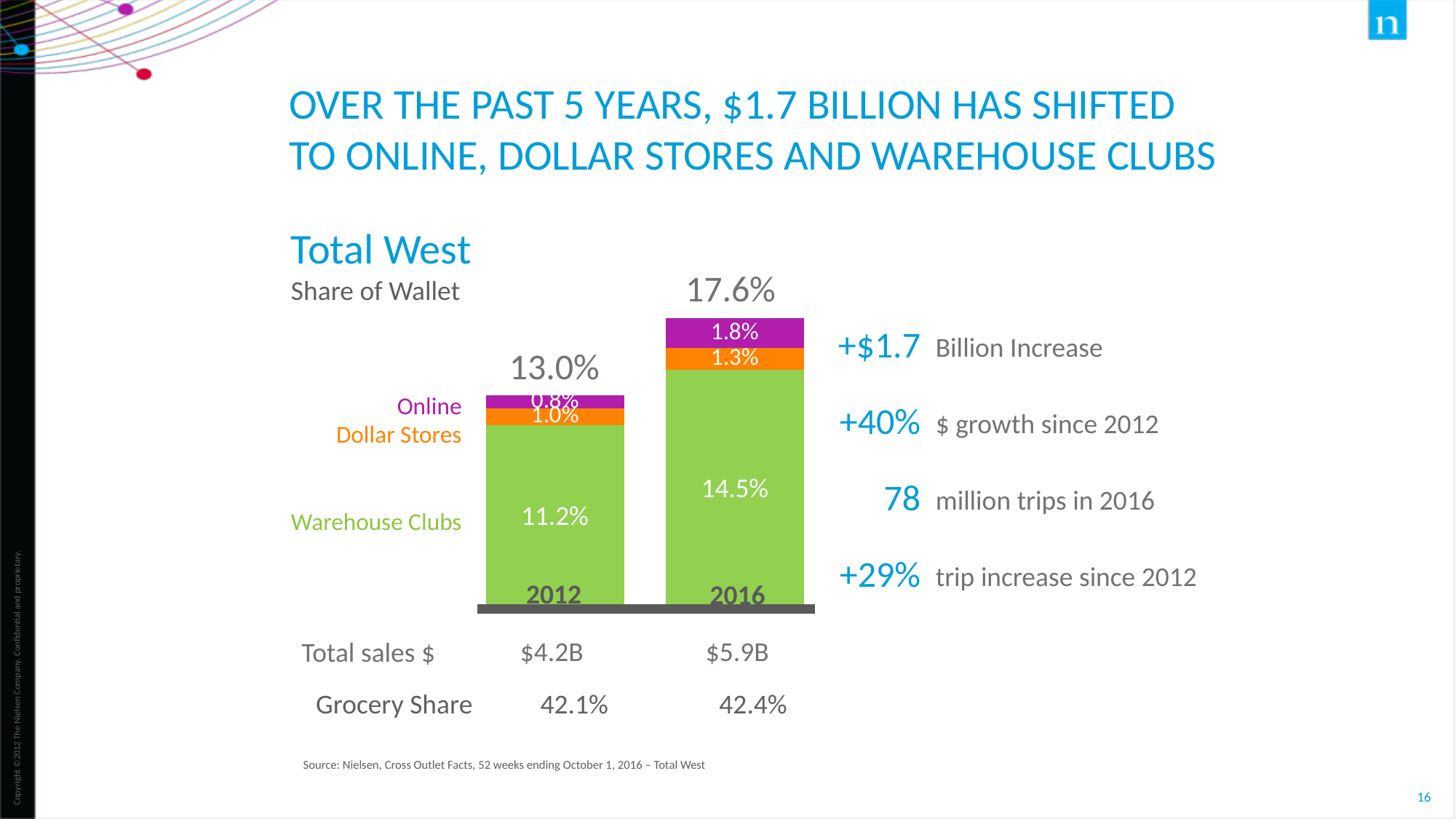
Which segment is the smallest in the 2012 bar? Online By how many percentage points did the Warehouse Clubs share change from 2012 to 2016? 3.3 percentage points How many years (bars) are shown in the chart? 2 What type of chart is shown on the slide? Stacked bar chart What is the Warehouse Clubs share of wallet in 2016? 14.5% What is the Online share of wallet in 2012? 0.8% How many segments (series) make up each stacked bar? 3 What is the total share of wallet shown for the 2016 bar? 17.6% What is the Dollar Stores share of wallet in 2016? 1.3% Which year has the higher total share of wallet, 2012 or 2016? 2016 What is the total share of wallet shown for the 2012 bar? 13.0% Which segment is the largest in the 2016 bar? Warehouse Clubs